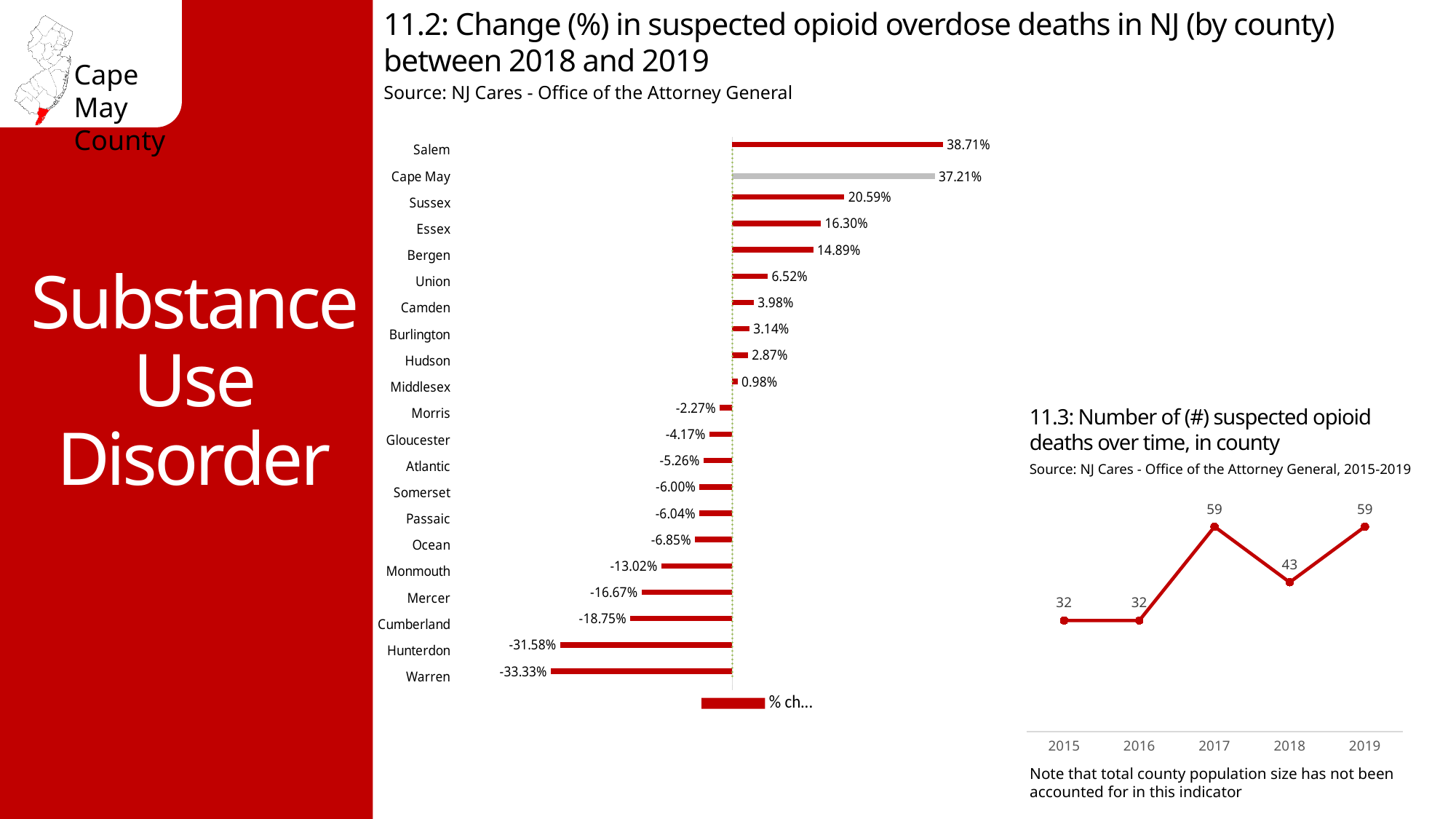
In the chart 11.2 (change in suspected opioid overdose deaths by county), what is the value for Cape May? 37.21% In the chart 11.2 (change in suspected opioid overdose deaths by county), what is the value for Monmouth? -13.02% In the chart 11.2 (change in suspected opioid overdose deaths by county), how many counties are shown? 21 In the chart 11.2 (change in suspected opioid overdose deaths by county), which county has the highest value? Salem In the chart 11.3 (number of suspected opioid deaths over time), what is the difference between the values for 2017 and 2016? 27 What kind of chart is chart 11.3 (number of suspected opioid deaths over time)? Line chart In the chart 11.2 (change in suspected opioid overdose deaths by county), which is larger, the value for Sussex or the value for Essex? Sussex What kind of chart is chart 11.2 (change in suspected opioid overdose deaths by county)? Bar chart In the chart 11.2 (change in suspected opioid overdose deaths by county), what is the difference between the values for Salem and Cape May? 1.50% In the chart 11.3 (number of suspected opioid deaths over time), what is the value for 2018? 43 In the chart 11.2 (change in suspected opioid overdose deaths by county), which county has the lowest value? Warren In the chart 11.3 (number of suspected opioid deaths over time), how many years are plotted? 5